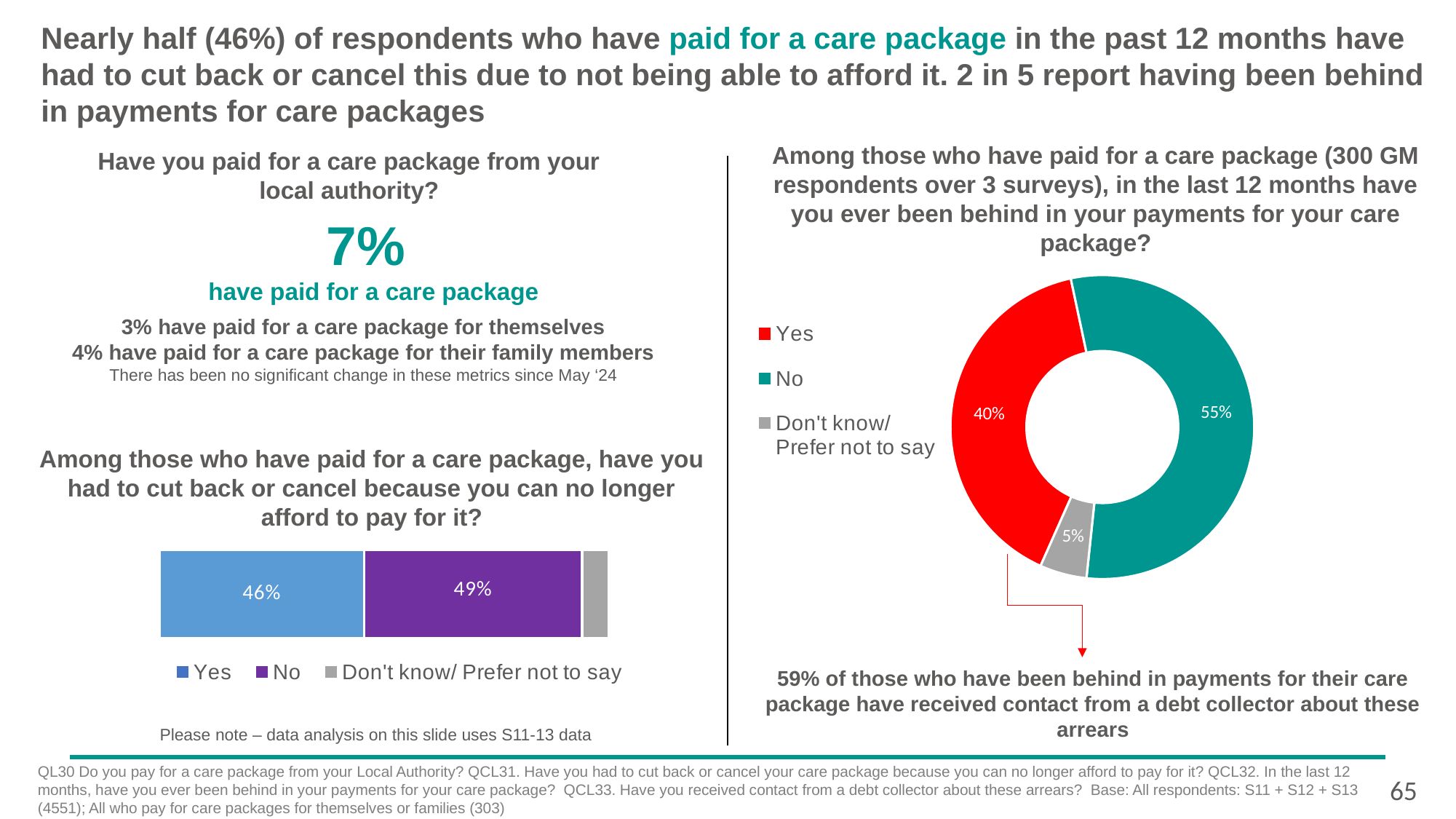
In the donut chart about being behind in payments for a care package, what colour is the Yes segment? Red In the stacked bar chart about cutting back or cancelling a care package, what percentage answered Yes? 46% How many series does the legend of the stacked bar chart about cutting back or cancelling a care package list? 3 In the donut chart about being behind in payments for a care package, which response has the smallest share? Don't know/ Prefer not to say In the donut chart about being behind in payments for a care package, what percentage answered Yes? 40% In the donut chart about being behind in payments for a care package, what percentage answered No? 55% In the donut chart about being behind in payments for a care package, what percentage answered Don't know/ Prefer not to say? 5% In the stacked bar chart about cutting back or cancelling a care package, what is the difference between the No and Yes percentages? 3 percentage points In the stacked bar chart about cutting back or cancelling a care package, what percentage answered No? 49% What type of chart is used for the question about cutting back or cancelling a care package? Bar chart In the stacked bar chart about cutting back or cancelling a care package, which response is larger, Yes or No? No In the donut chart about being behind in payments for a care package, which response has the largest share? No